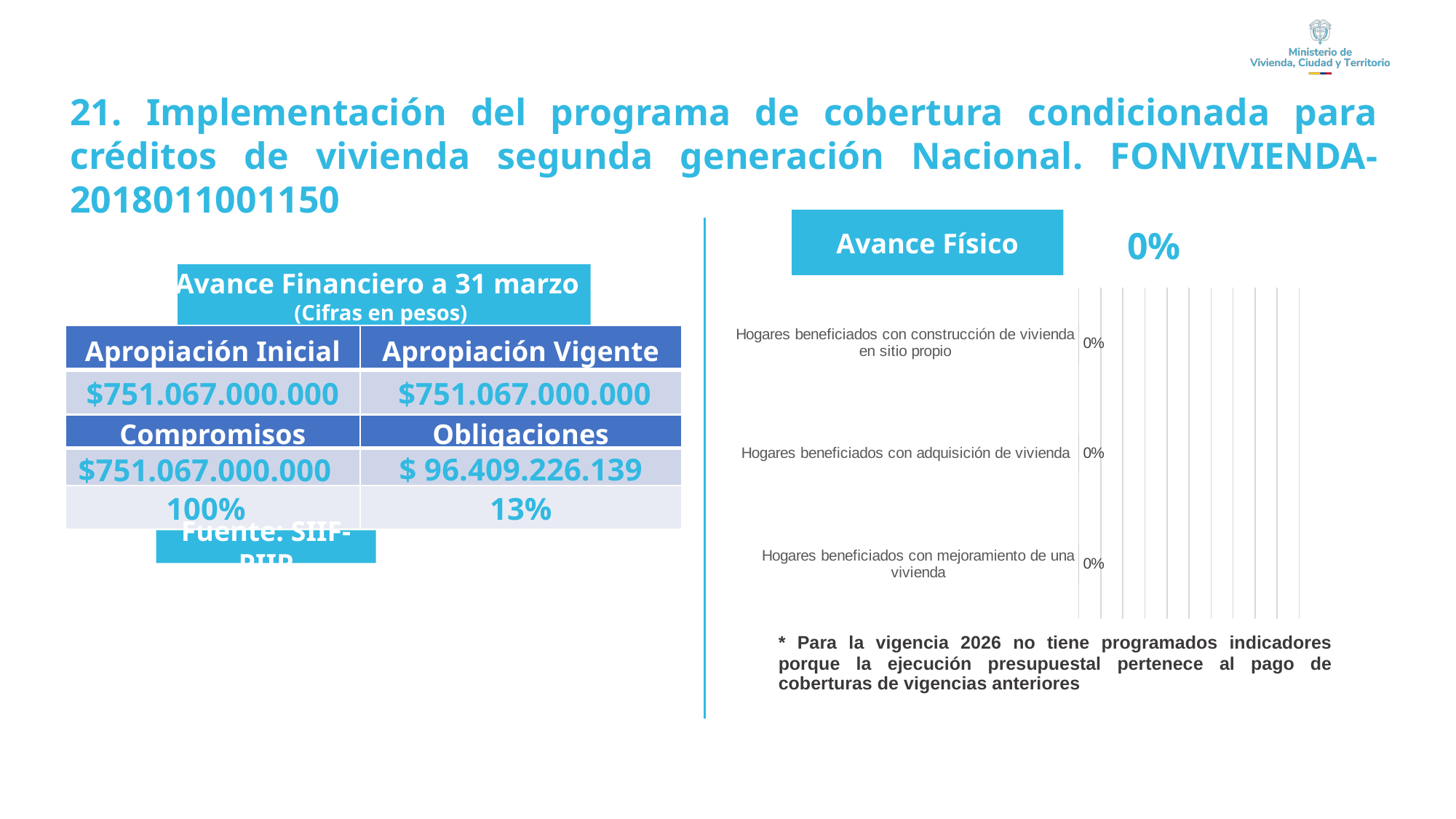
What overall percentage is printed next to the 'Avance Físico' chart title? 0% In the 'Avance Físico' chart, what is the difference between the value for 'Hogares beneficiados con adquisición de vivienda' and the value for 'Hogares beneficiados con mejoramiento de una vivienda'? 0% Do the values in the 'Avance Físico' chart rise, fall, or stay the same across the three categories? stay the same What is the title of the chart on the right side of the slide? Avance Físico In the 'Avance Físico' chart, what is the value for 'Hogares beneficiados con mejoramiento de una vivienda'? 0% In the 'Avance Físico' chart, what is the value for 'Hogares beneficiados con construcción de vivienda en sitio propio'? 0% In the 'Avance Físico' chart, what is the value for 'Hogares beneficiados con adquisición de vivienda'? 0% How many categories does the 'Avance Físico' bar chart show? 3 What kind of chart is shown under the 'Avance Físico' heading? bar chart